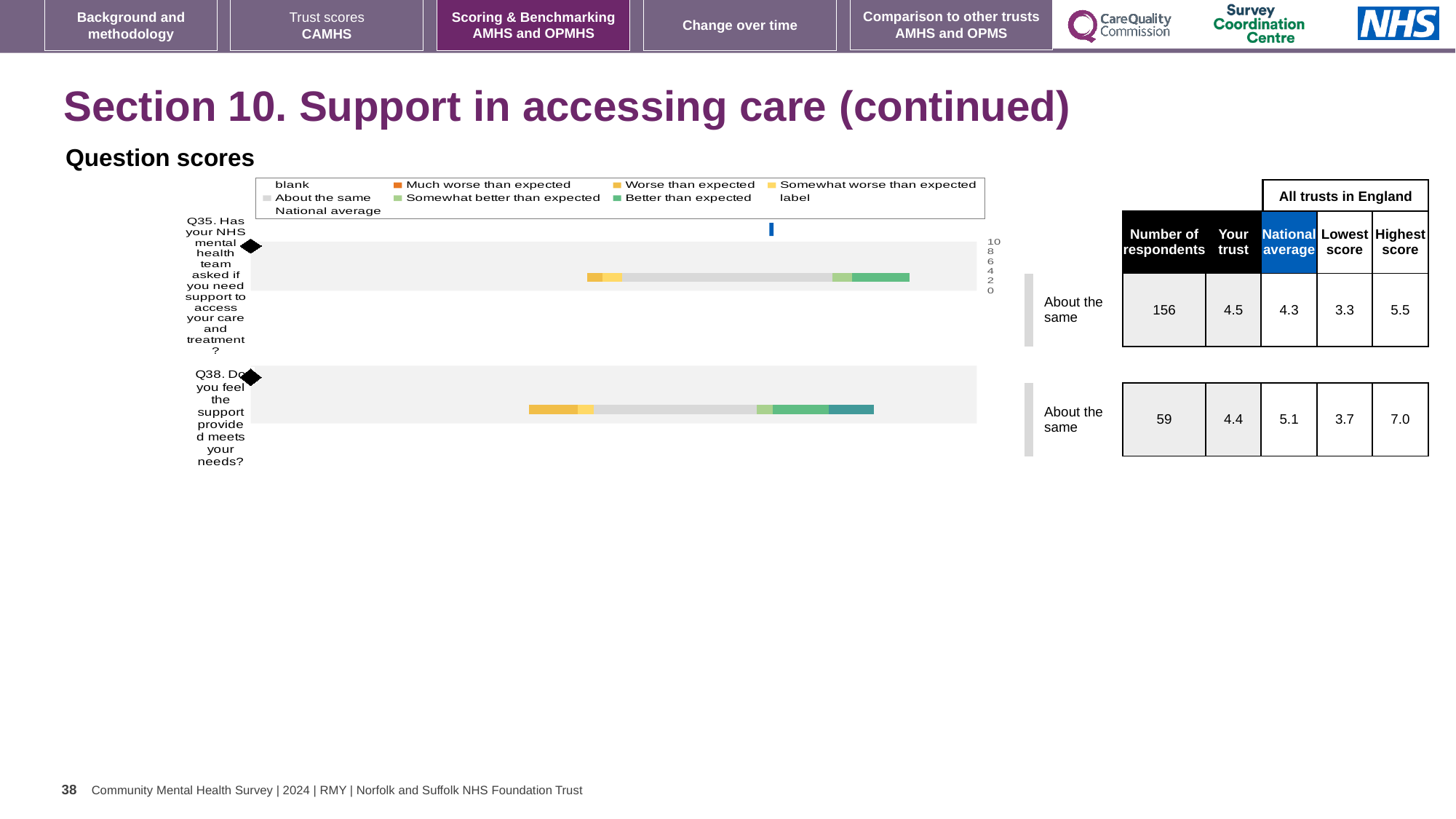
What is the difference between the highest score and the lowest score for Q38? 3.3 What is the lowest score among all trusts in England for Q35? 3.3 What is the national average score for Q35? 4.3 For Q35, which is higher: the 'Your trust' score or the national average? Your trust What is the national average score for Q38? 5.1 Which question has more respondents, Q35 or Q38? Q35 How many questions are plotted in the question scores chart? 2 What is the 'Your trust' score for Q35 (Has your NHS mental health team asked if you need support to access your care and treatment?)? 4.5 What kind of chart is used to show the question scores on this slide? bar chart What is the highest score among all trusts in England for Q38? 7.0 How many respondents answered Q35? 156 What is the 'Your trust' score for Q38 (Do you feel the support provided meets your needs?)? 4.4